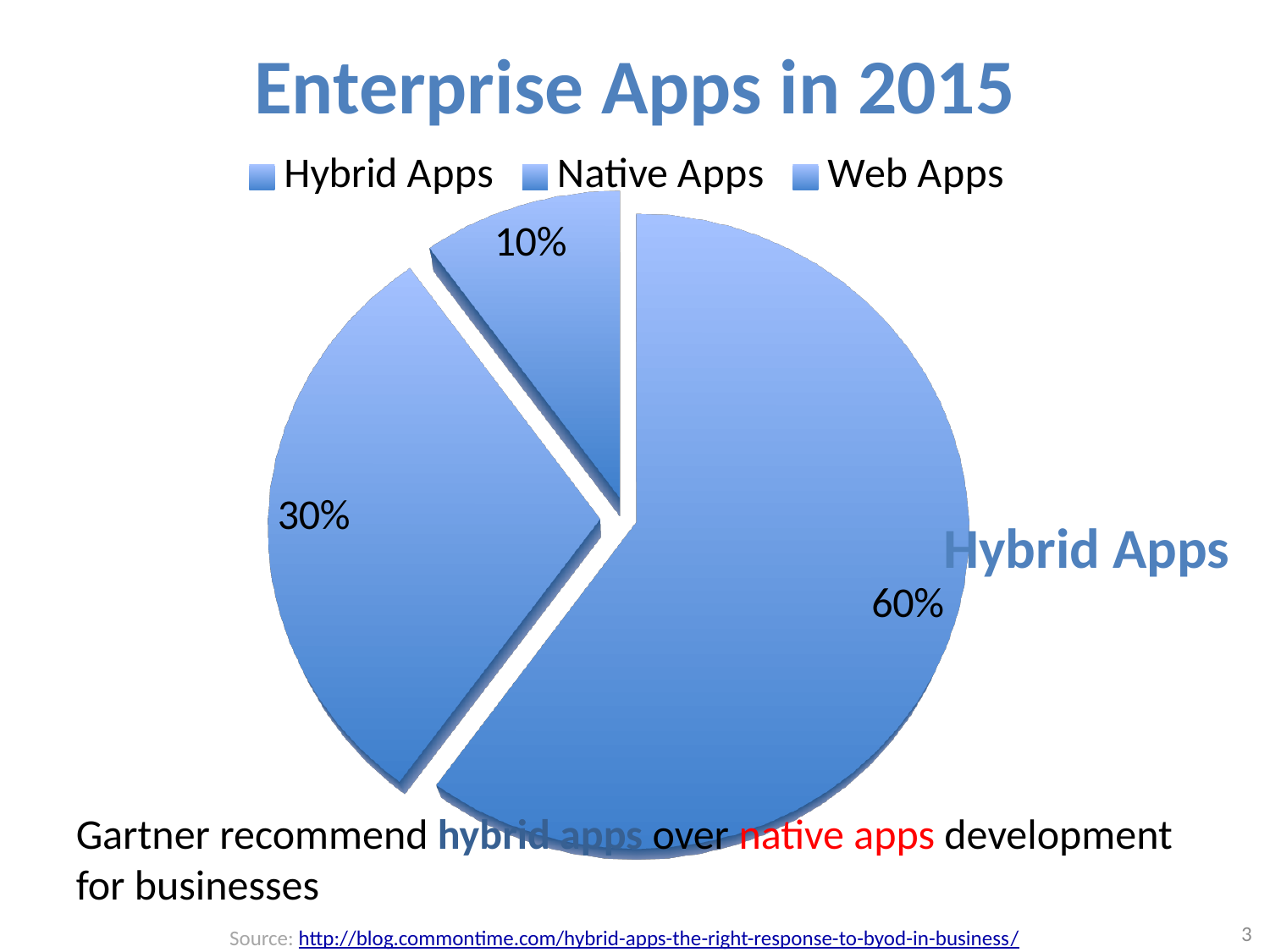
How many categories does the legend list? 3 What type of chart is shown on the slide? pie chart Which category has the largest slice of the pie? Hybrid Apps Which is larger, the 30% slice or the 10% slice? the 30% slice What is the value of the smallest slice in the pie chart? 10% What is the difference between the largest slice and the smallest slice? 50 percentage points How many slices does the pie chart have? 3 What is the value of the largest slice in the pie chart? 60% Is the share for Hybrid Apps greater or less than 50%? greater What share of the pie do Hybrid Apps account for? 60% Which legend entry is listed first? Hybrid Apps What is the title of the chart? Enterprise Apps in 2015